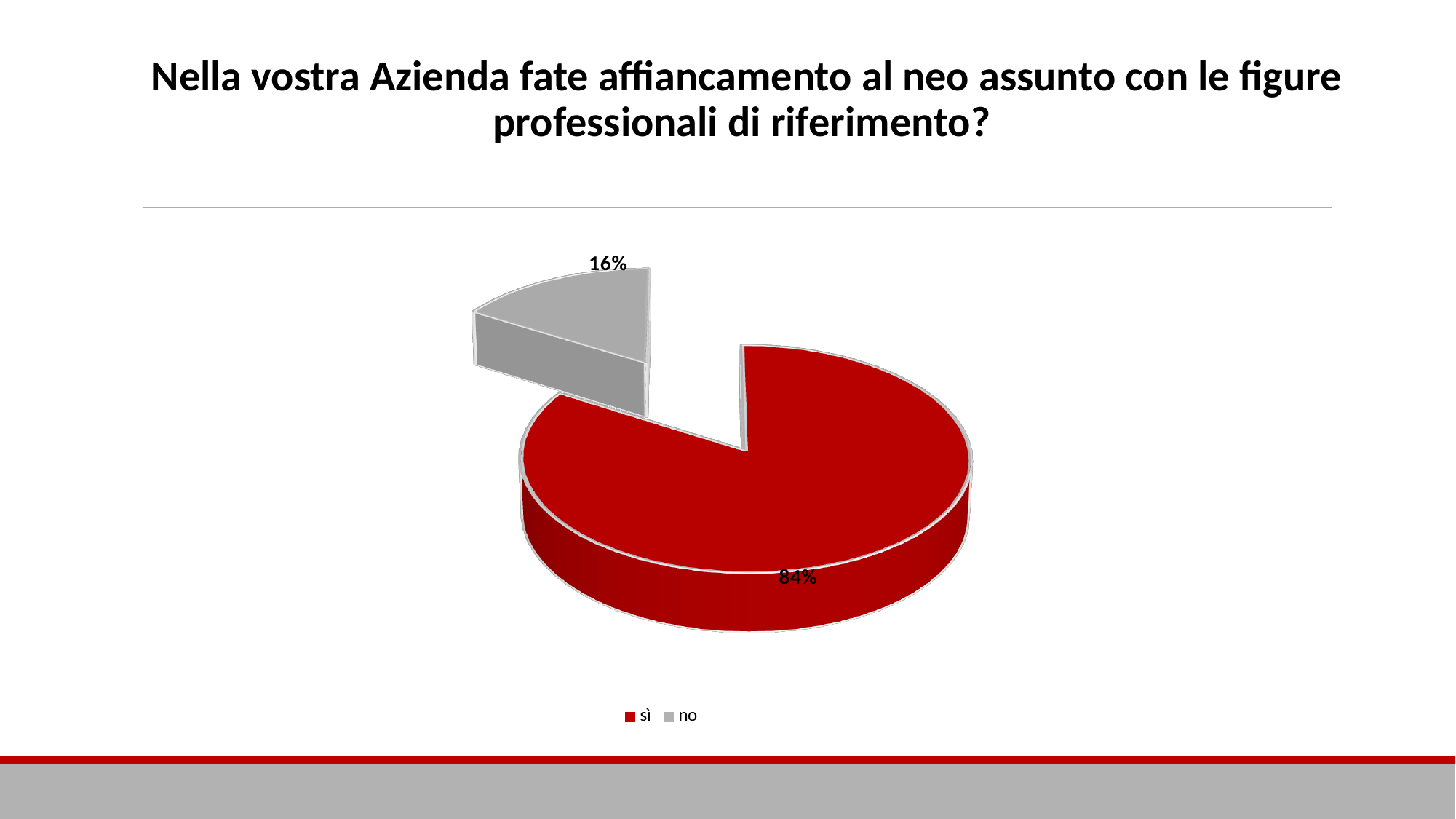
Which is larger, the "sì" slice or the "no" slice? sì What colour is the "sì" slice? red How many entries does the legend list? 2 What percentage of the pie is labelled "sì"? 84% What colour is the "no" slice? grey What is the difference in percentage points between the "sì" and "no" slices? 68 How many slices does the pie chart have? 2 What percentage of the pie is labelled "no"? 16% What kind of chart is shown on the slide? pie chart Which slice of the pie is the largest? sì Which slice of the pie is the smallest? no What share of the pie does the "no" slice represent? 16%